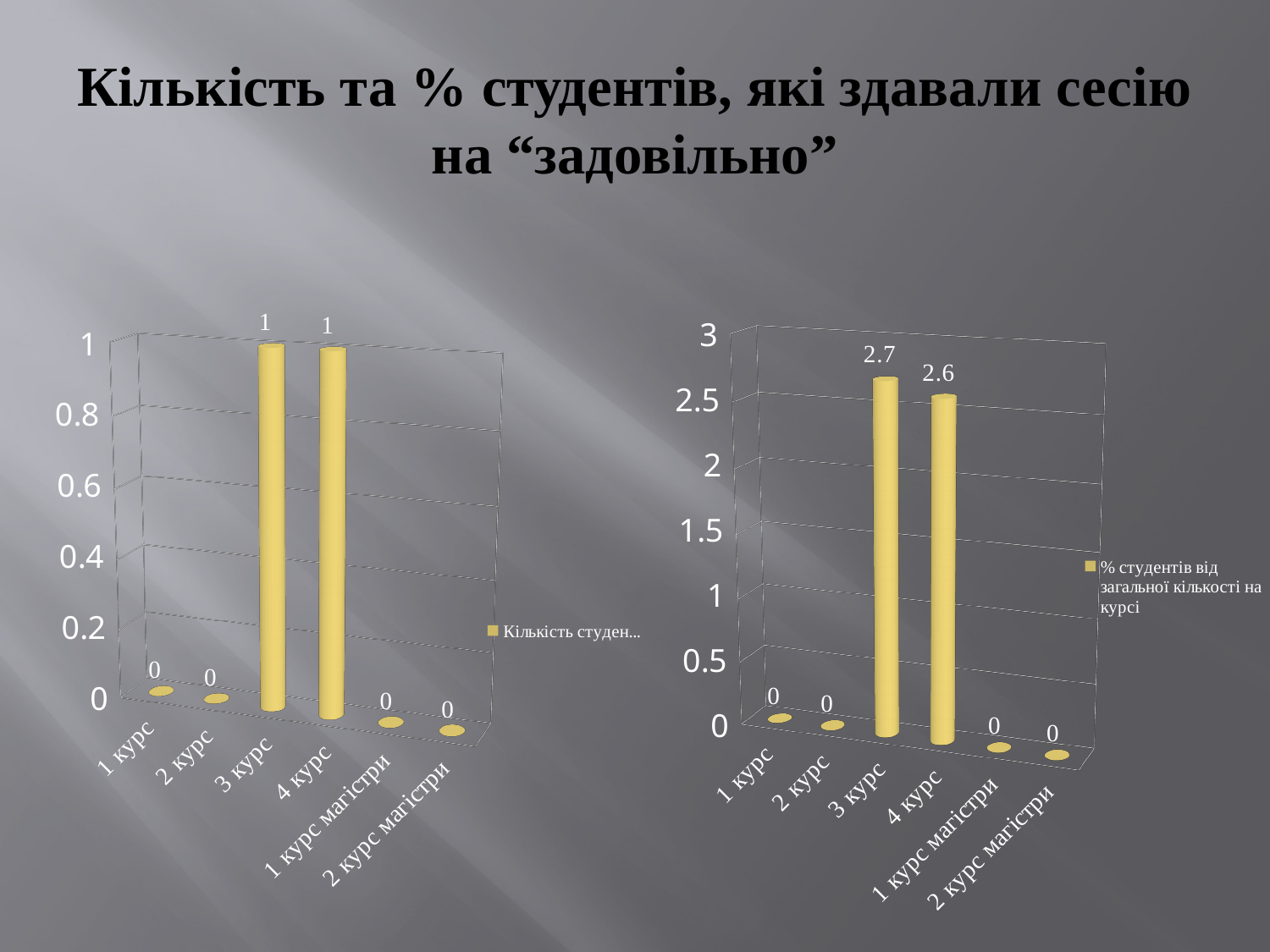
In the right chart, what is the difference between the values for 3 курс and 4 курс? 0.1 In the right chart, which category has the highest value? 3 курс In the left chart, what is the value for 3 курс? 1 What is the legend entry of the right chart? % студентів від загальної кількості на курсі How many categories are shown on the x axis of the left chart? 6 In the right chart, what is the value for 3 курс? 2.7 In the right chart, what is the value for 4 курс? 2.6 In the right chart, is the value for 3 курс greater or less than 2.5? greater How many series does the legend of the right chart list? 1 In the left chart, what is the value for 1 курс магістри? 0 What kind of chart is the left chart? bar chart In the right chart, what is the value for 2 курс магістри? 0